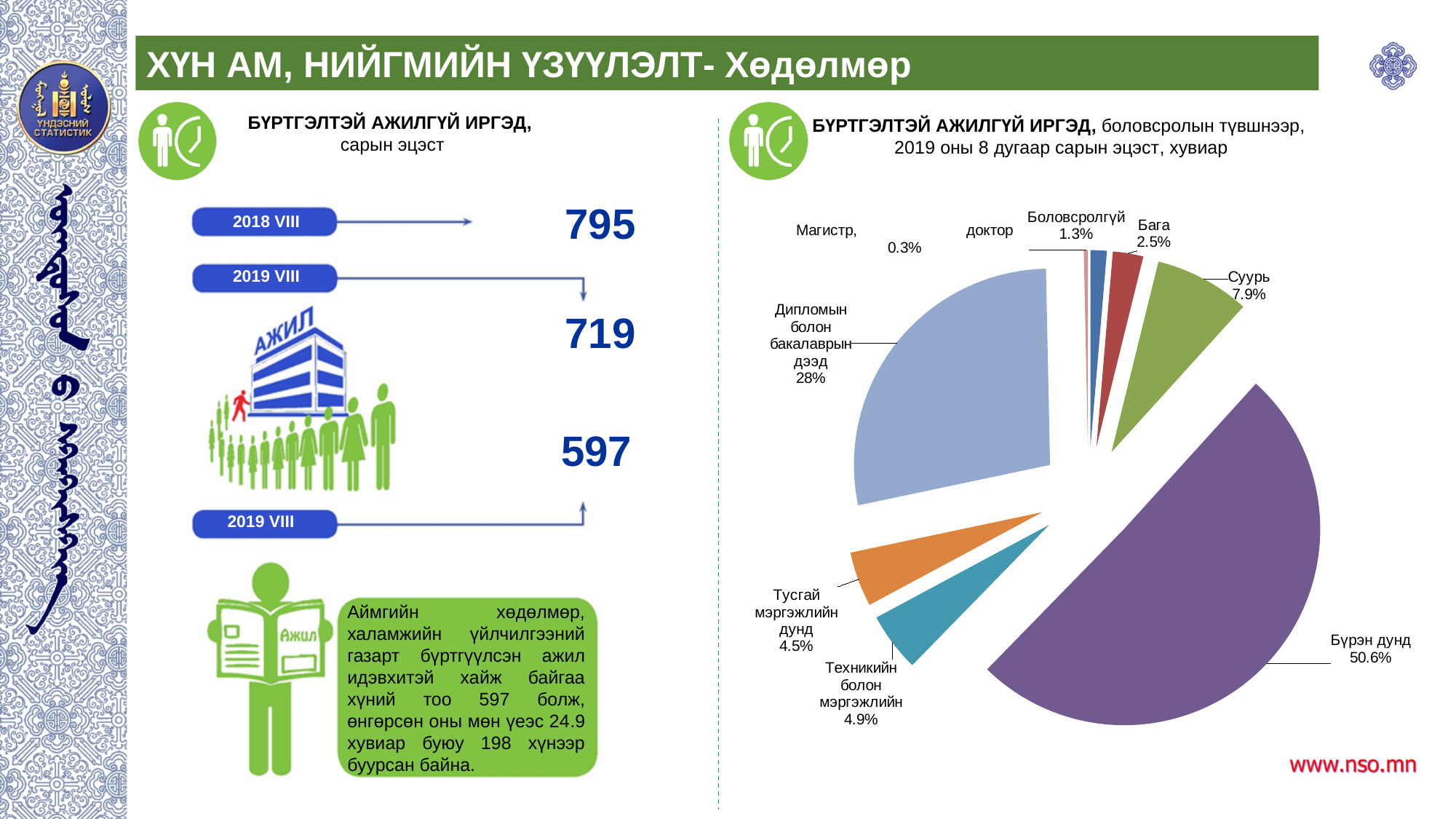
In the pie chart, what share is labelled for Суурь? 7.9% In the pie chart, what is the difference in percentage points between Бүрэн дунд and Дипломын болон бакалаврын дээд? 22.6 In the pie chart, what share is labelled for Техникийн болон мэргэжлийн? 4.9% In the pie chart, which slice is larger: Техникийн болон мэргэжлийн or Тусгай мэргэжлийн дунд? Техникийн болон мэргэжлийн In the pie chart, what share is labelled for Боловсролгүй? 1.3% In the pie chart, what share is labelled for Дипломын болон бакалаврын дээд? 28% Which category has the largest slice in the pie chart? Бүрэн дунд What kind of chart is shown on the right side of the slide? Pie chart In the pie chart, which slice is larger: Суурь or Бага? Суурь Which category has the smallest slice in the pie chart? Магистр, доктор How many slices does the pie chart have? 8 In the pie chart, what share is labelled for Бүрэн дунд? 50.6%